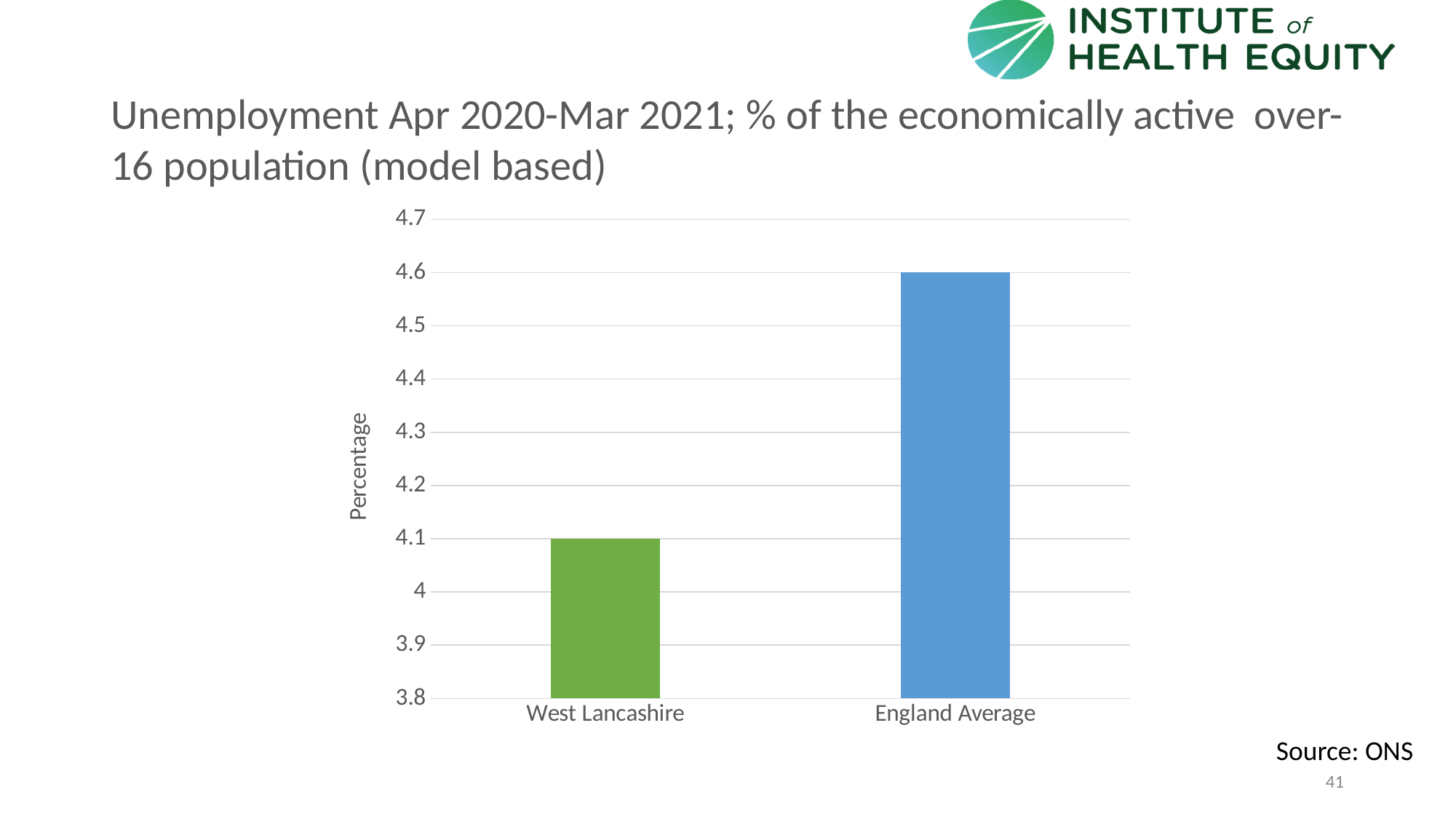
Which category has the highest value? England Average Is the value for West Lancashire greater or less than 4.4? less Which is larger, the value for West Lancashire or the value for England Average? England Average What kind of chart is shown on the slide? bar chart What colour is the bar for West Lancashire? green What is the unemployment value for West Lancashire? 4.1 Which category has the lowest value? West Lancashire How many categories are shown on the x axis? 2 What is the label on the vertical axis? Percentage What is the difference between the England Average value and the West Lancashire value? 0.5 Is the value for England Average greater or less than 4.3? greater What is the unemployment value for England Average? 4.6